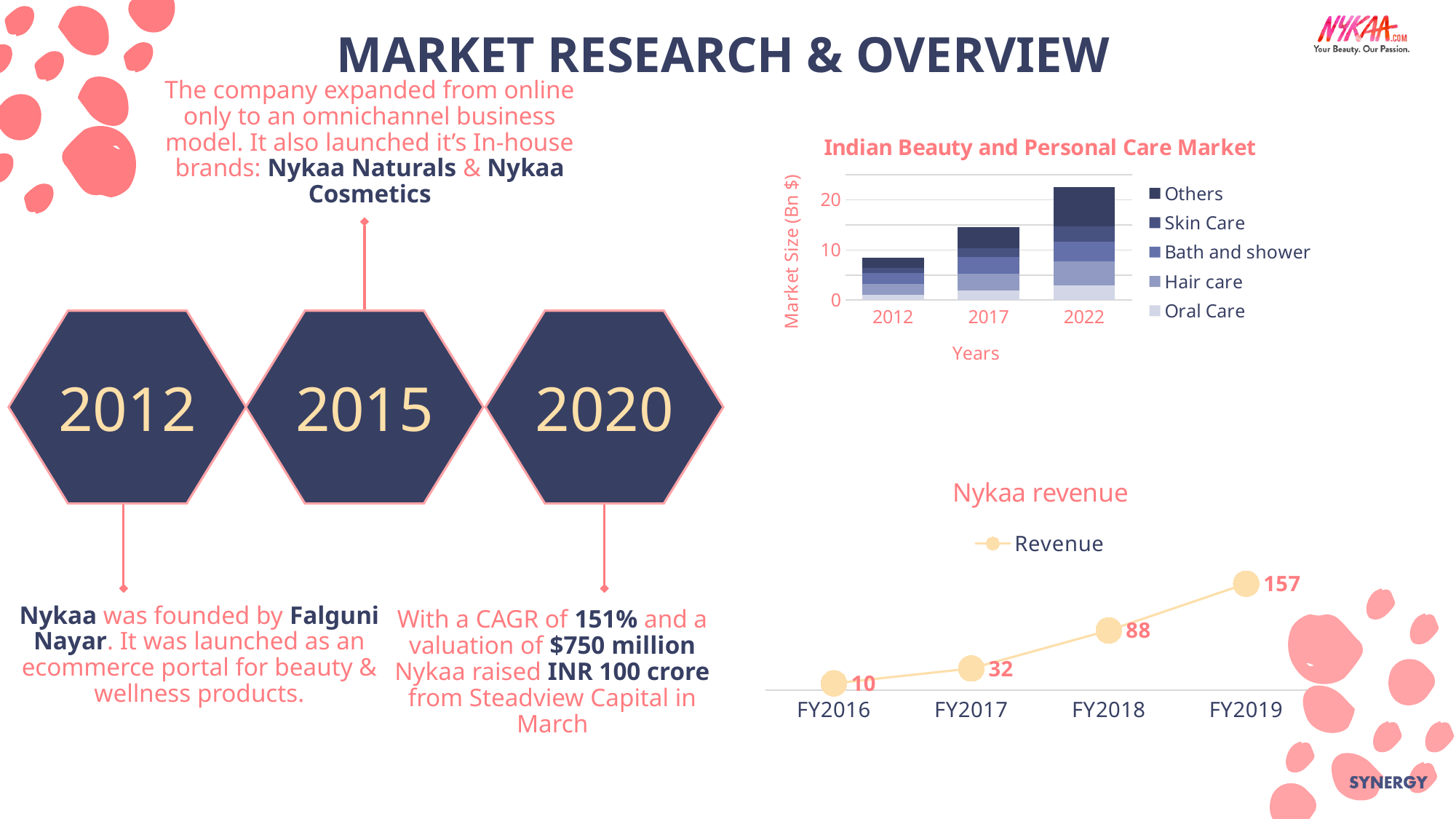
In the Indian Beauty and Personal Care Market chart, how many series does the legend list? 5 In the Indian Beauty and Personal Care Market chart, is the total market size for 2022 greater or less than 20? greater In the Nykaa revenue chart, what is the revenue for FY2017? 32 In the Nykaa revenue chart, how many data points are plotted? 4 In the Nykaa revenue chart, which fiscal year has the lowest revenue? FY2016 In the Nykaa revenue chart, do the values rise or fall from FY2016 to FY2019? rise In the Nykaa revenue chart, what is the difference between the FY2018 and FY2017 revenue values? 56 In the Indian Beauty and Personal Care Market chart, is the total market size for 2012 greater or less than 10? less In the Nykaa revenue chart, what is the revenue for FY2019? 157 In the Indian Beauty and Personal Care Market chart, which year has the tallest bar? 2022 What kind of chart is the Nykaa revenue chart? line chart What is the y-axis label of the Indian Beauty and Personal Care Market chart? Market Size (Bn $)